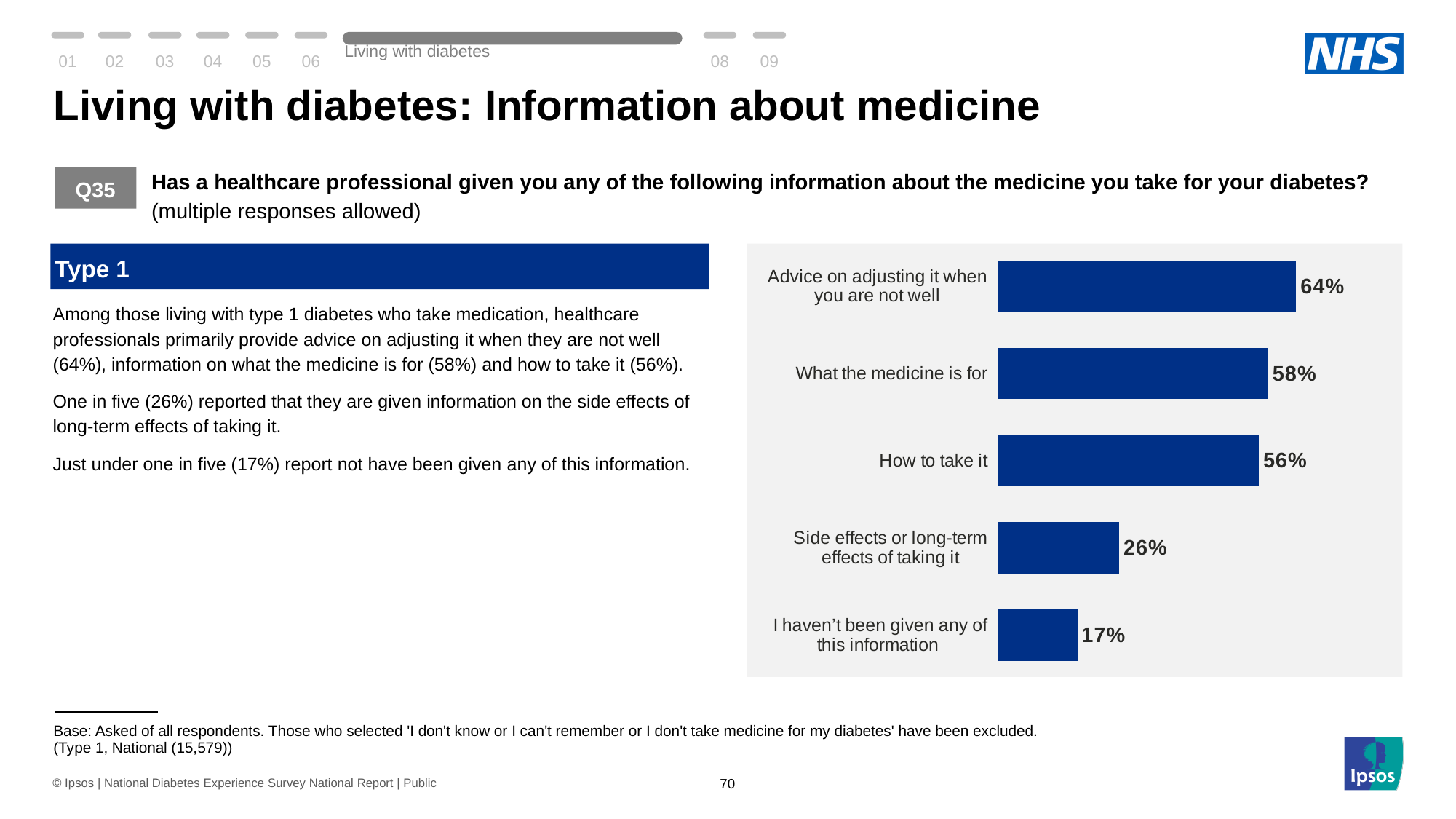
What is the difference in percentage points between 'Advice on adjusting it when you are not well' and 'Side effects or long-term effects of taking it'? 38 percentage points Which category has the lowest value in the chart? I haven't been given any of this information Which category has the highest value in the chart? Advice on adjusting it when you are not well What percentage of respondents were given information on side effects or long-term effects of taking it? 26% What percentage of respondents were given information on what the medicine is for? 58% What percentage of respondents were told how to take their medicine? 56% What percentage of respondents were given advice on adjusting their medicine when they are not well? 64% What type of chart is shown on the slide? Bar chart Which is larger: the value for 'What the medicine is for' or the value for 'How to take it'? What the medicine is for How many categories are shown in the chart? 5 What percentage of respondents said they haven't been given any of this information? 17% Which group of respondents does the chart on this slide cover? Type 1